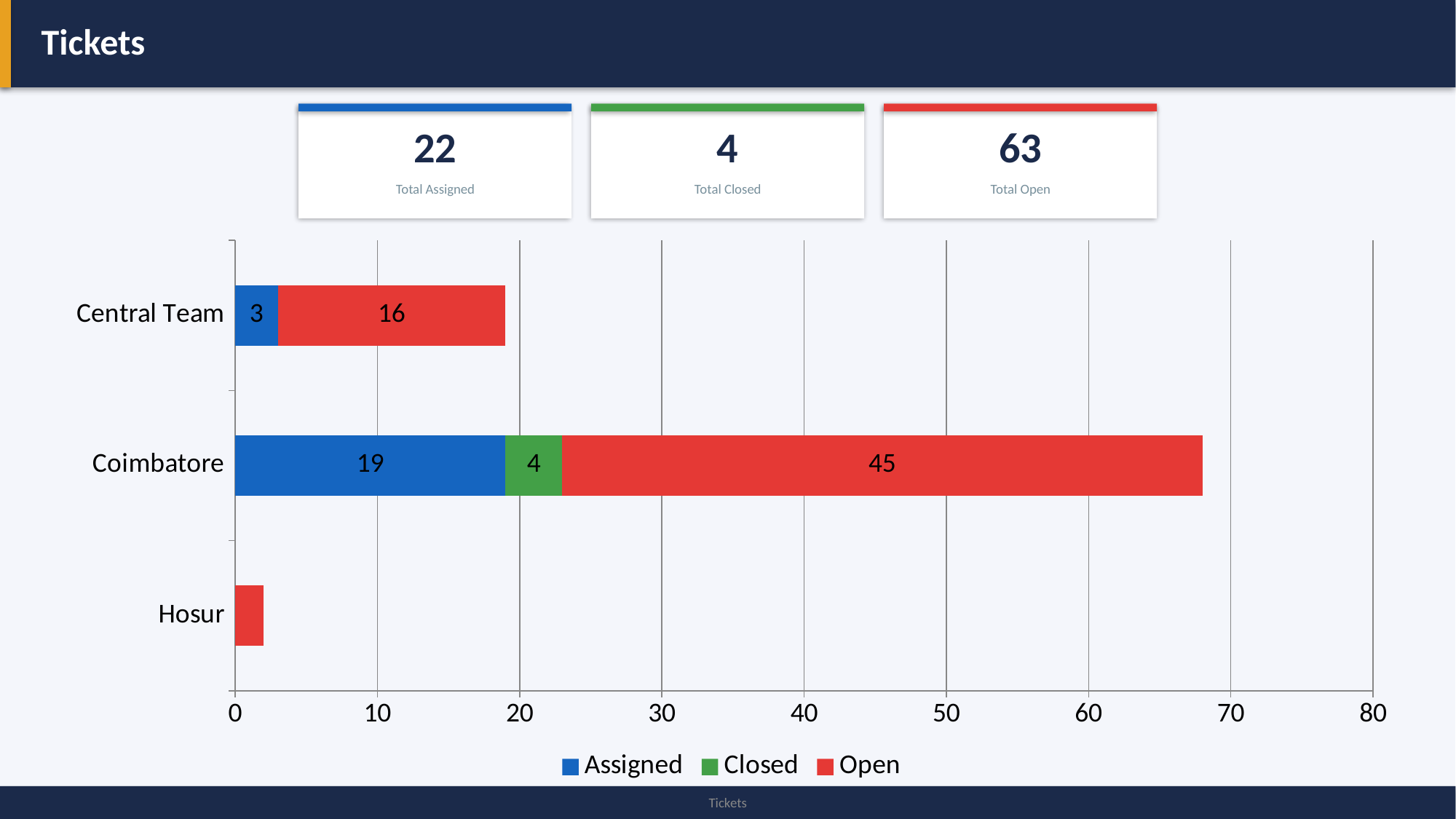
Is the Open value for Hosur greater or less than 10? less What kind of chart is shown on the slide? stacked bar chart What is the total of the stacked bar for Coimbatore? 68 What is the Assigned value for Central Team? 3 Which has a larger Assigned value, Coimbatore or Central Team? Coimbatore What is the Open value for Central Team? 16 What is the Open value for Coimbatore? 45 Which category has the highest Open value? Coimbatore How many categories are shown on the y axis of the chart? 3 What is the difference between the Open value for Coimbatore and the Open value for Central Team? 29 What is the Closed value for Coimbatore? 4 How many series does the legend list? 3